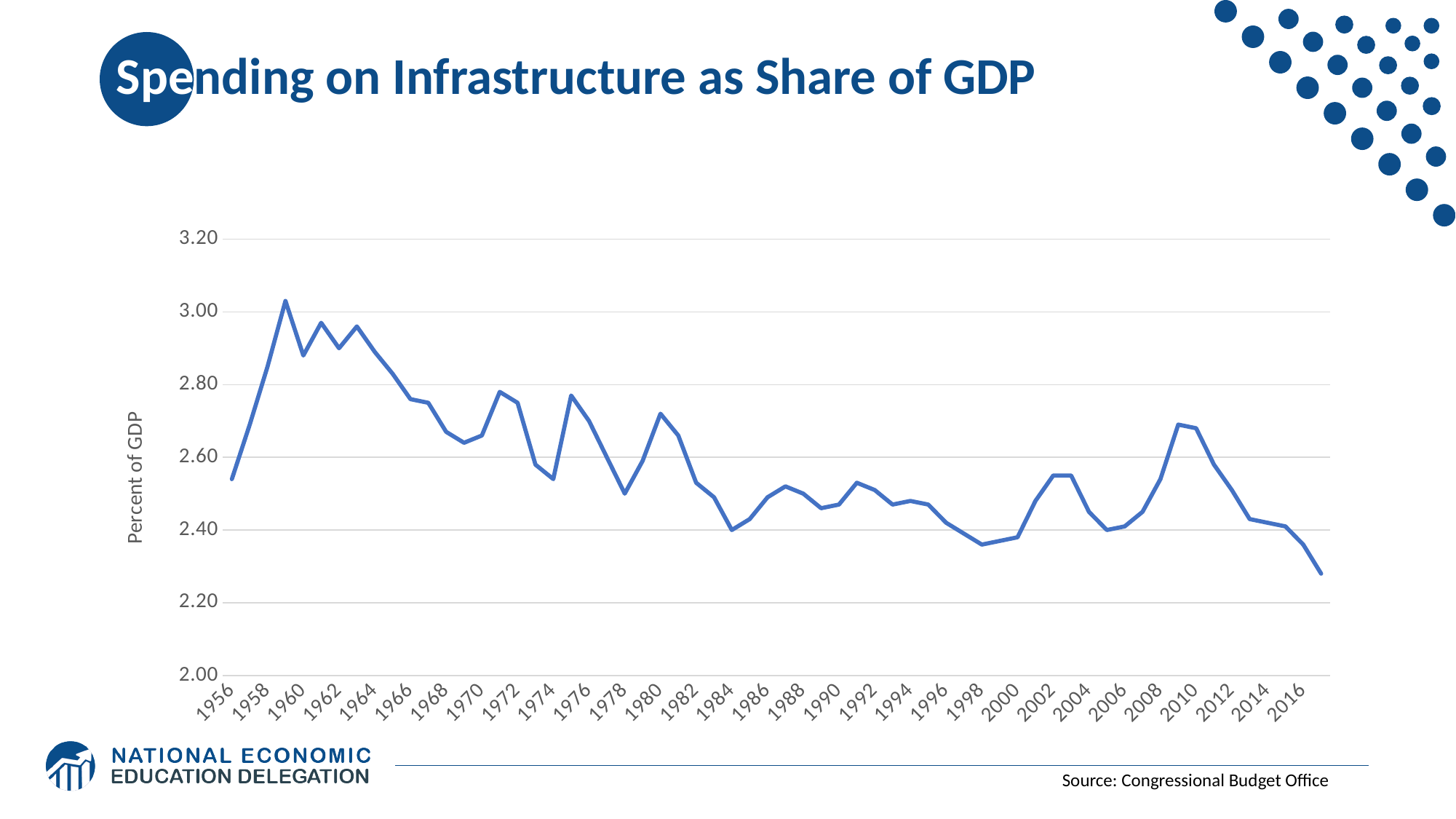
What kind of chart is shown on the slide? line chart Is the value for 1990 greater or less than 2.60? less What is the label on the vertical axis? Percent of GDP Which year has the larger value, 1972 or 1974? 1972 Is the value for 1960 greater or less than 2.80? greater Is the value for 1956 greater or less than 2.60? less Which year has the larger value, 1960 or 2010? 1960 Overall, do the values rise or fall from 1956 to the end of the series? fall What is the source cited for the chart? Congressional Budget Office